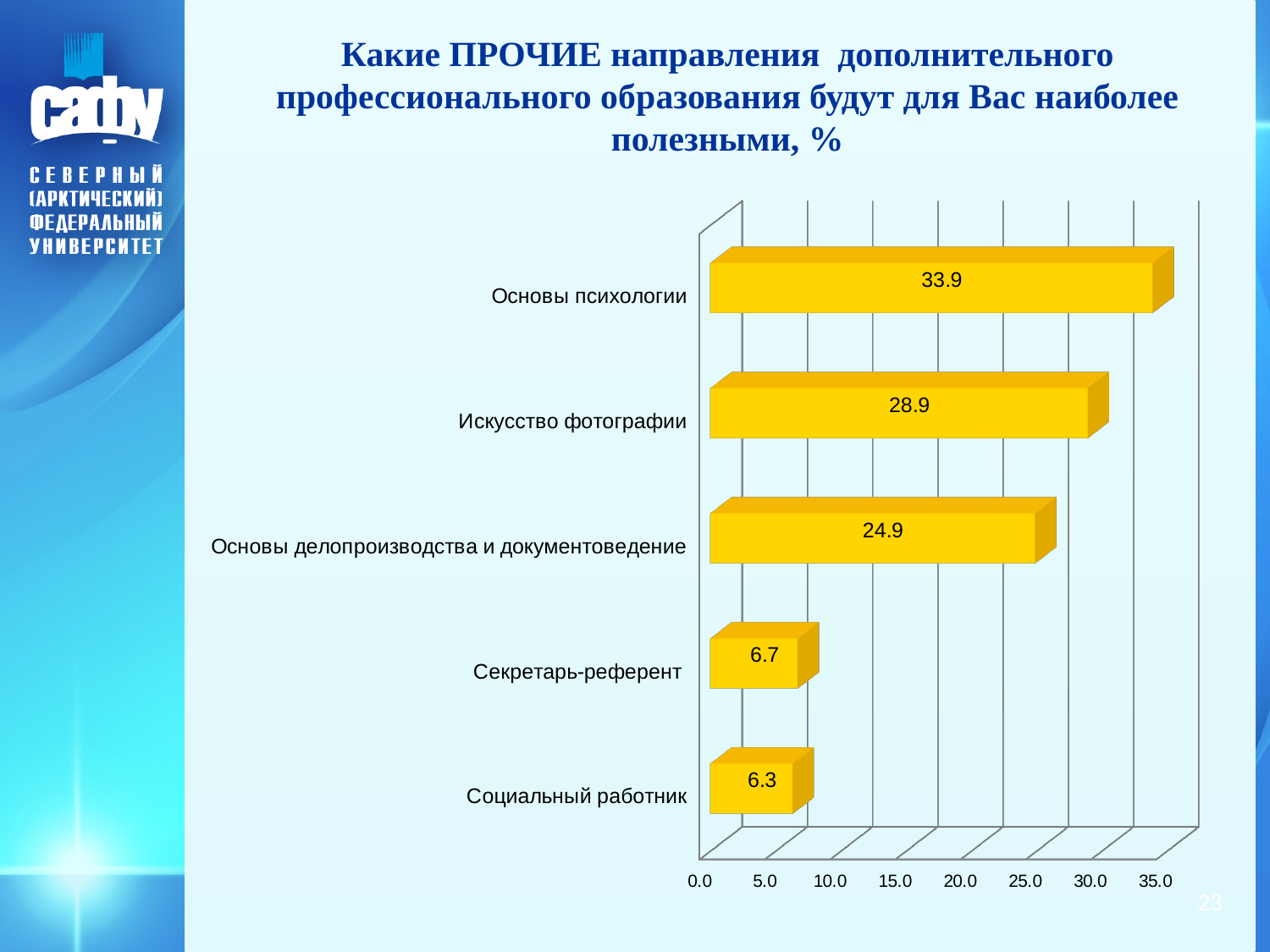
What is the maximum value shown on the horizontal axis? 35.0 Which category has the highest value? Основы психологии What is the value for Секретарь-референт? 6.7 How many categories are shown in the chart? 5 Which is larger: the value for Основы делопроизводства и документоведение or the value for Секретарь-референт? Основы делопроизводства и документоведение What is the value for Искусство фотографии? 28.9 What kind of chart is shown on the slide? Bar chart What is the value for Основы делопроизводства и документоведение? 24.9 What is the value for Социальный работник? 6.3 What is the difference between the values for Основы психологии and Искусство фотографии? 5.0 Which category has the lowest value? Социальный работник What is the value for Основы психологии? 33.9